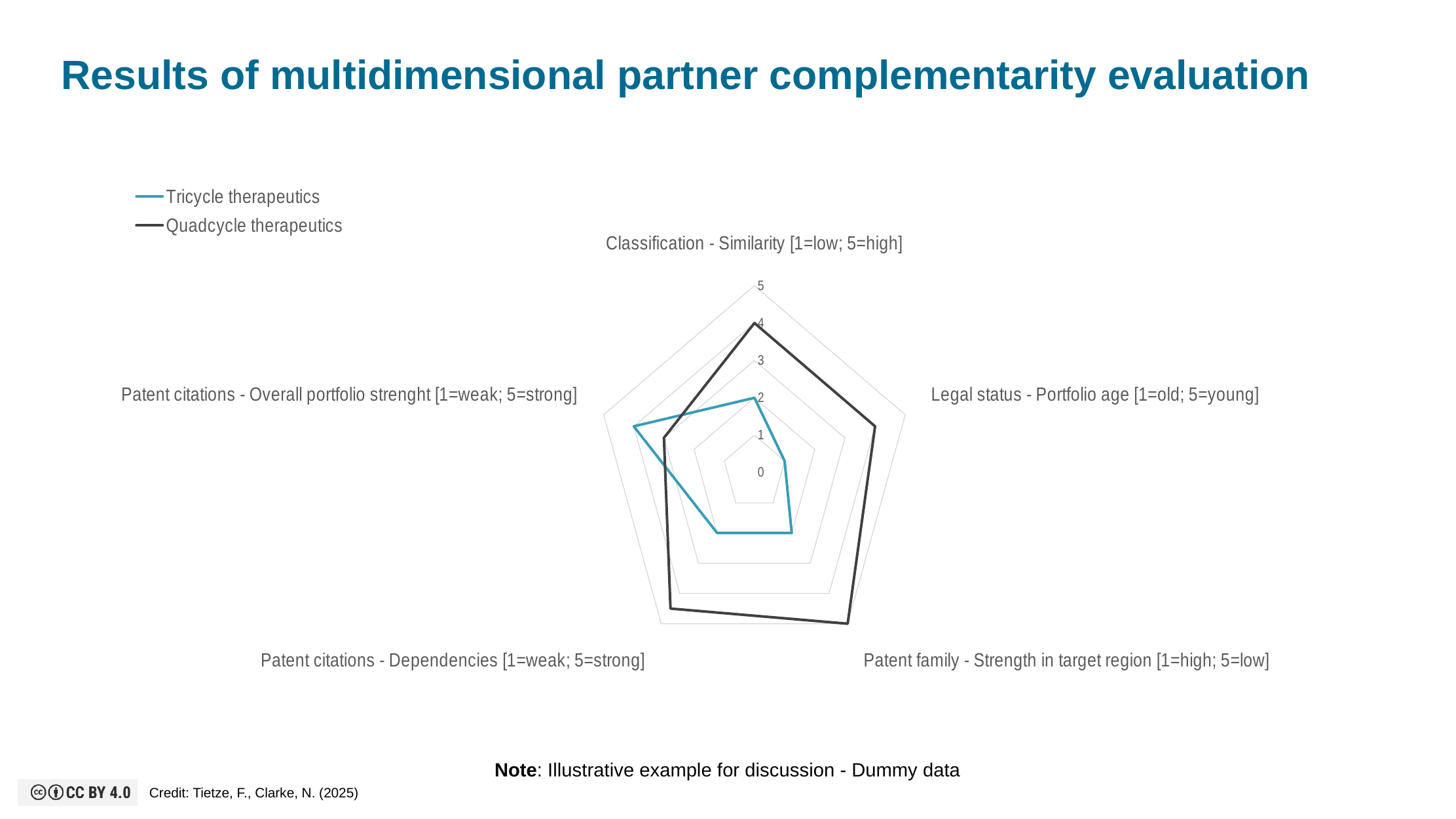
What kind of chart is shown on the slide? Radar chart What is the difference between Quadcycle therapeutics and Tricycle therapeutics on the Classification - Similarity axis? 2 What is the value for Quadcycle therapeutics on the Classification - Similarity axis? 4 Is the value for Quadcycle therapeutics on the Patent citations - Dependencies axis greater or less than 3? greater Is the value for Tricycle therapeutics on the Legal status - Portfolio age axis greater or less than 3? less How many evaluation dimensions (axes) does the radar chart have? 5 Which series has the higher value on the Patent citations - Overall portfolio strenght axis? Tricycle therapeutics Which series has the higher value on the Legal status - Portfolio age axis? Quadcycle therapeutics Which colour is used for the Tricycle therapeutics series in the legend? Blue How many series does the legend list? 2 Is the value for Quadcycle therapeutics on the Patent family - Strength in target region axis greater or less than 3? greater What is the value for Tricycle therapeutics on the Classification - Similarity axis? 2